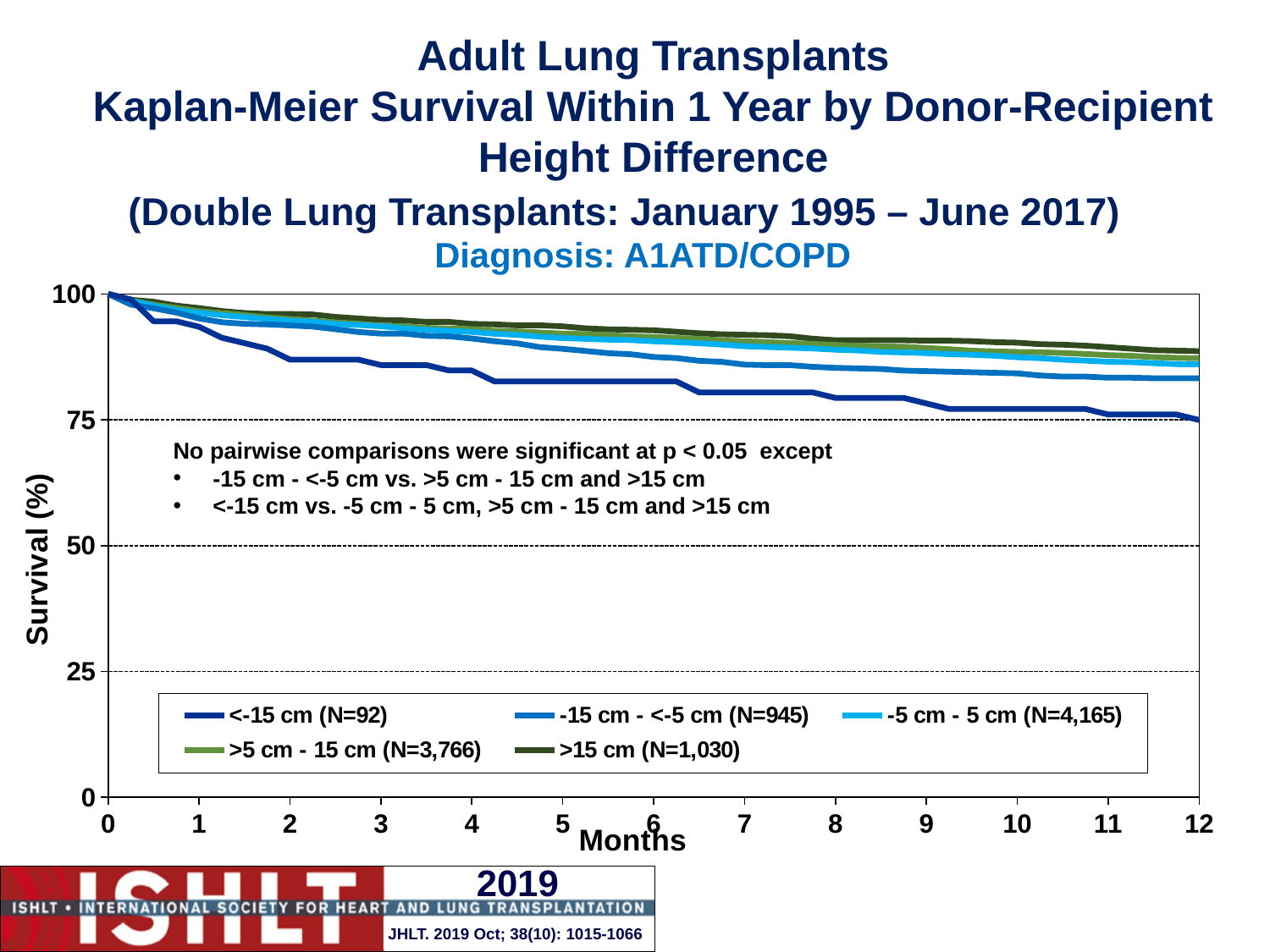
Which height-difference group has the lowest survival at 12 months? <-15 cm (N=92) What kind of chart is shown on the slide? line chart What diagnosis does the chart cover? A1ATD/COPD What is the label of the y-axis? Survival (%) Is the survival for the <-15 cm group at 6 months greater or less than 75? greater Which height-difference group has the highest survival at 12 months? >15 cm (N=1,030) How many patients (N) are in the -5 cm - 5 cm group according to the legend? 4,165 At 12 months, which group has higher survival: <-15 cm or -15 cm - <-5 cm? -15 cm - <-5 cm Do the survival curves rise or fall as months increase? fall How many series does the legend list? 5 Is the survival for the >15 cm group at 12 months greater or less than 75? greater Is the survival for the -5 cm - 5 cm group at 12 months greater or less than 100? less